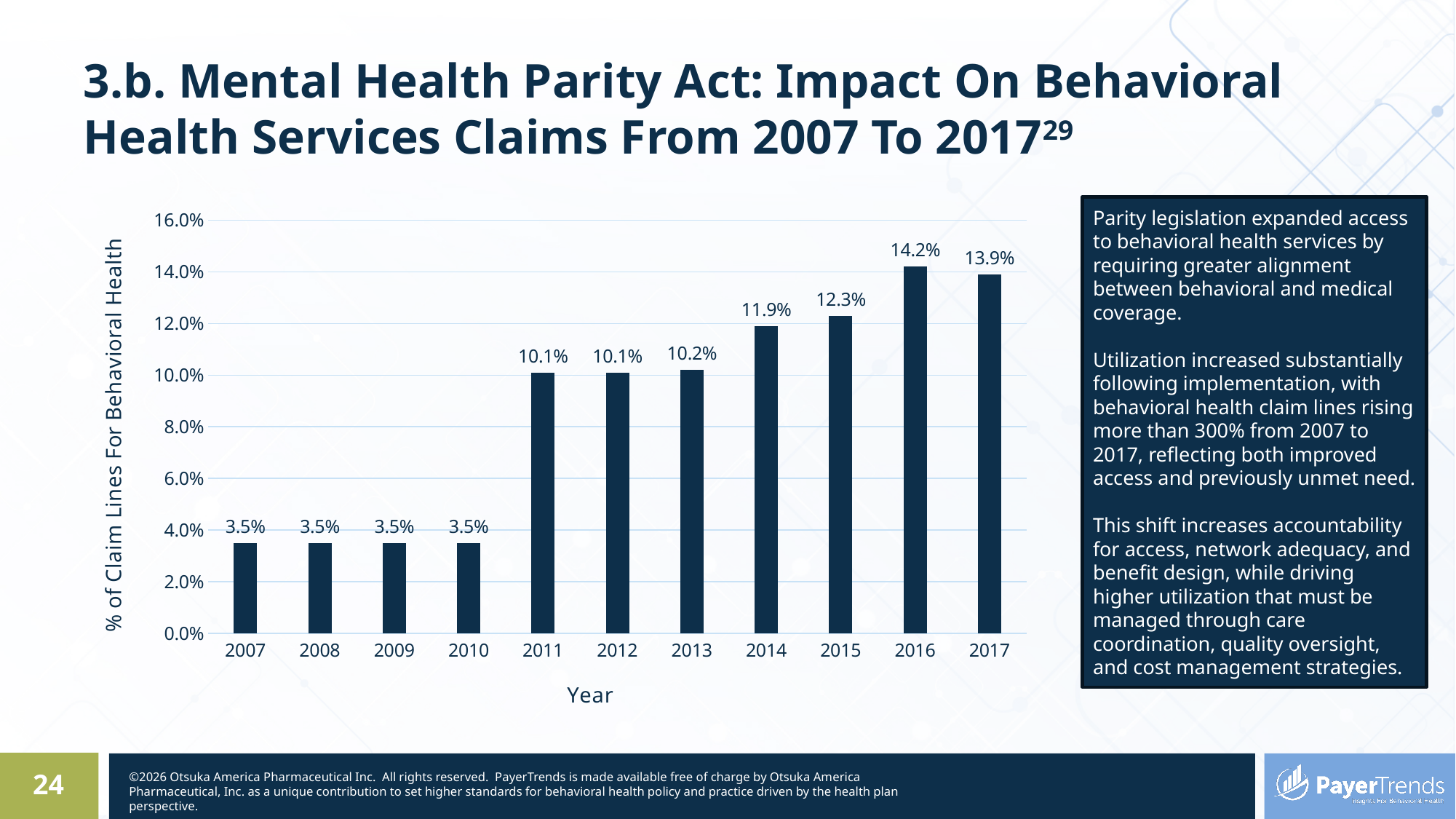
Which is larger, the value for 2014 or the value for 2013? 2014 What kind of chart is shown on the slide? bar chart Which year has the highest value? 2016 What is the difference between the values for 2016 and 2015? 1.9% Do the values generally rise or fall from 2007 to 2016? rise What is the value for 2011? 10.1% What is the difference between the values for 2017 and 2007? 10.4% Is the value for 2015 greater or less than 12.0%? greater What is the value for 2016? 14.2% How many years are shown on the x axis? 11 What is the value for 2007? 3.5% What is the label of the y axis? % of Claim Lines For Behavioral Health